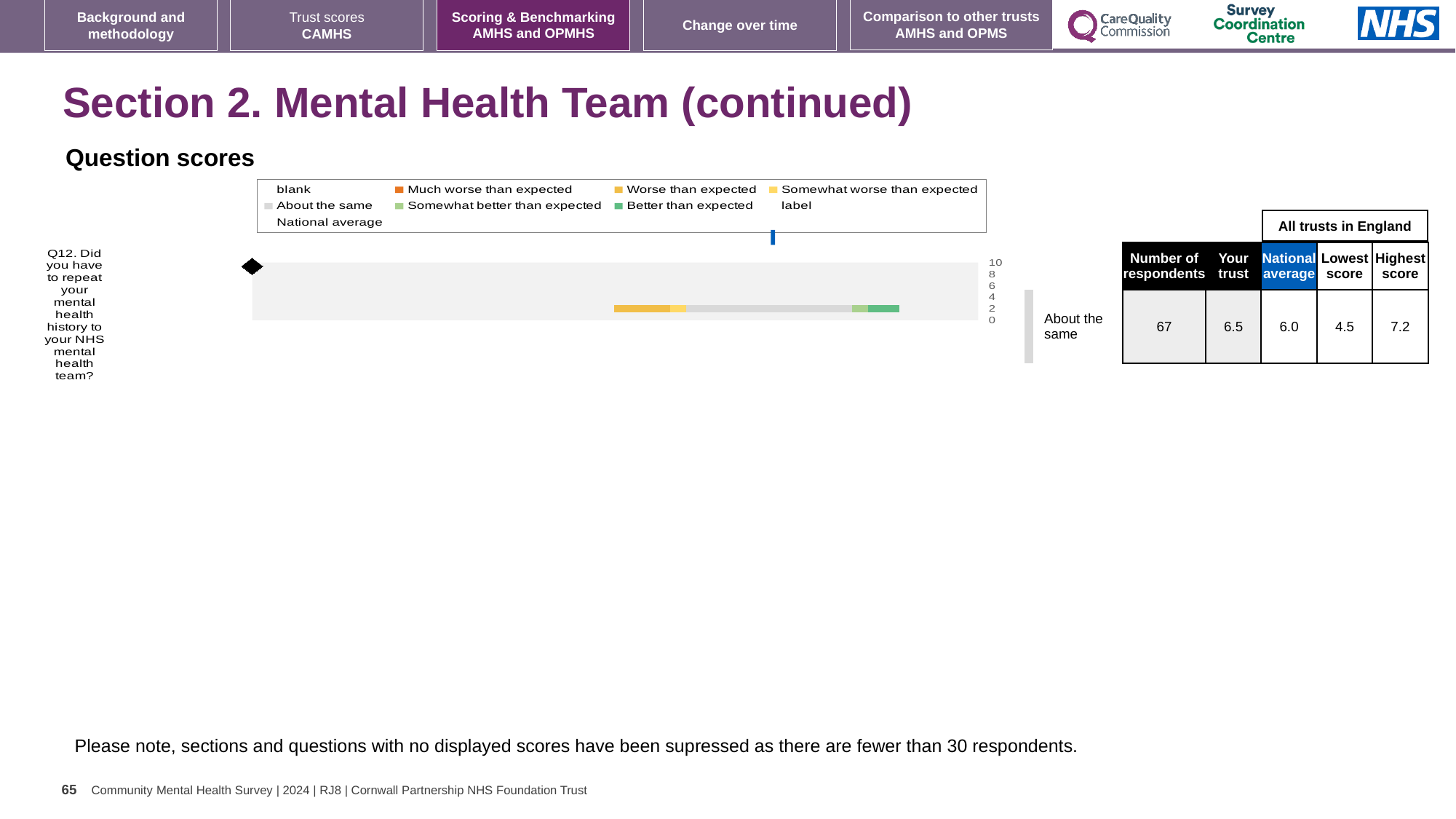
What is the 'Your trust' score for Q12? 6.5 How many survey questions are plotted in the question scores chart? 1 What is the number of respondents for Q12? 67 What is the national average score for Q12? 6.0 Which question is plotted in the question scores chart? Q12. Did you have to repeat your mental health history to your NHS mental health team? What is the highest score among all trusts in England for Q12? 7.2 What benchmark category is shown for Q12 in the question scores chart? About the same What kind of chart is used to show the question scores on this slide? Bar chart What is the lowest score among all trusts in England for Q12? 4.5 Is the 'Your trust' score for Q12 higher or lower than the national average? Higher What is the difference between the highest and lowest scores among all trusts in England for Q12? 2.7 What is the difference between the 'Your trust' score and the national average for Q12? 0.5